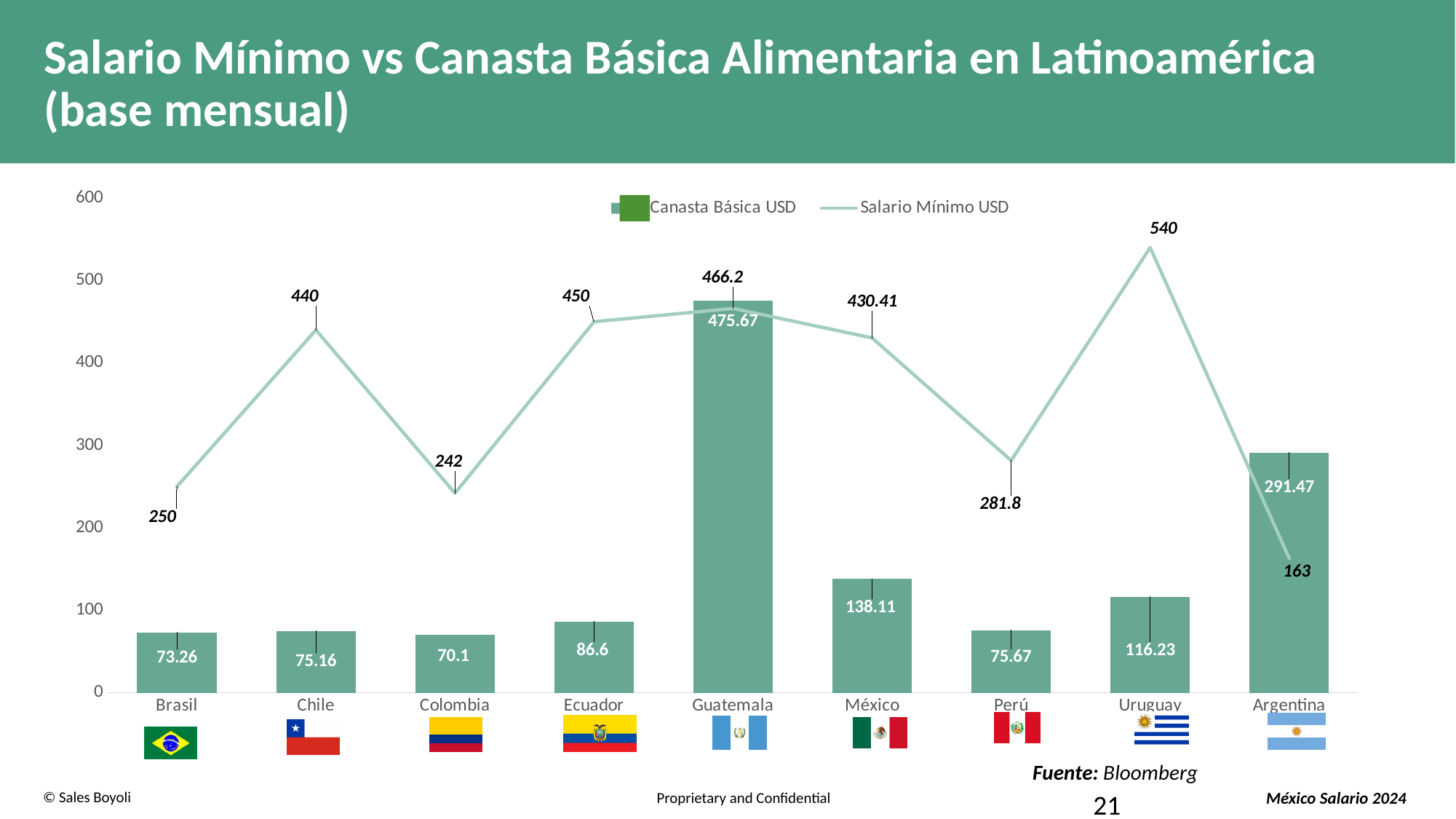
What is the Salario Mínimo USD value for Perú? 281.8 Which country has the lowest Salario Mínimo USD value? Argentina For Argentina, how much larger is the Canasta Básica USD value than the Salario Mínimo USD value? 128.47 How many series does the chart legend list? 2 How many countries are shown on the x axis of the chart? 9 What kind of chart is shown on the slide? A bar chart combined with a line chart What is the difference between the Salario Mínimo USD values for Chile and Colombia? 198 Which country has the highest Canasta Básica USD value? Guatemala Which country has the lowest Canasta Básica USD value? Colombia For Guatemala, which is larger: the Canasta Básica USD value or the Salario Mínimo USD value? Canasta Básica USD What is the Canasta Básica USD value for México? 138.11 What is the Salario Mínimo USD value for Uruguay? 540